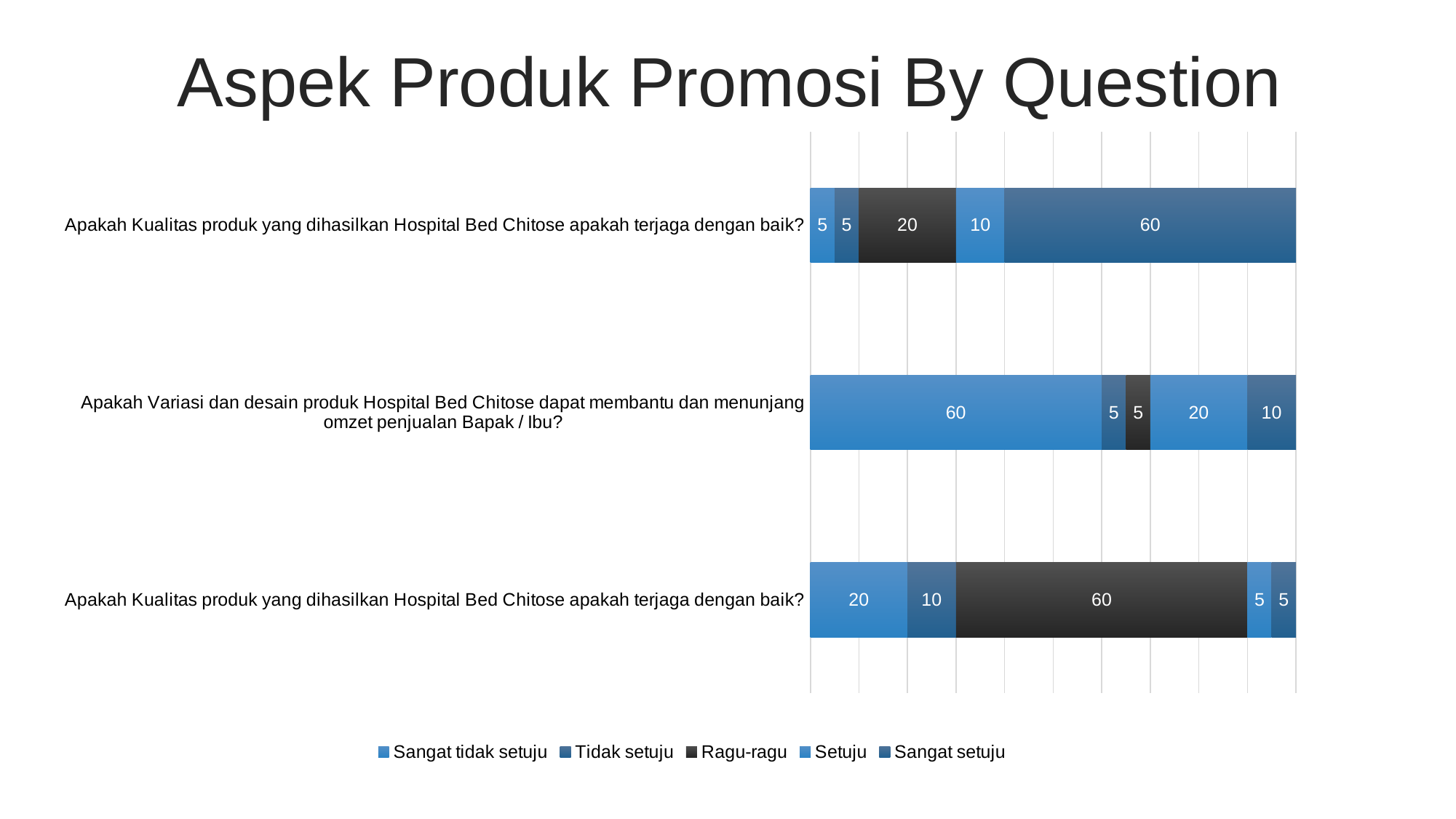
How many series does the legend list? 5 How many question categories (bars) are plotted in the chart? 3 Which bar has the larger Ragu-ragu value, the top bar or the middle bar? The top bar What is the title of the chart slide? Aspek Produk Promosi By Question What is the Ragu-ragu value for the bottom bar in the chart? 60 What is the Ragu-ragu value for the question 'Apakah Variasi dan desain produk Hospital Bed Chitose dapat membantu dan menunjang omzet penjualan Bapak / Ibu?'? 5 What is the total of the top stacked bar in the chart? 100 What is the Ragu-ragu value for the top bar in the chart? 20 What is the largest segment value in the middle bar of the chart? 60 What is the difference between the Ragu-ragu value of the bottom bar and the Ragu-ragu value of the middle bar? 55 What kind of chart is shown on the slide? Stacked bar chart What is the total of the stacked bar for 'Apakah Variasi dan desain produk Hospital Bed Chitose dapat membantu dan menunjang omzet penjualan Bapak / Ibu?'? 100